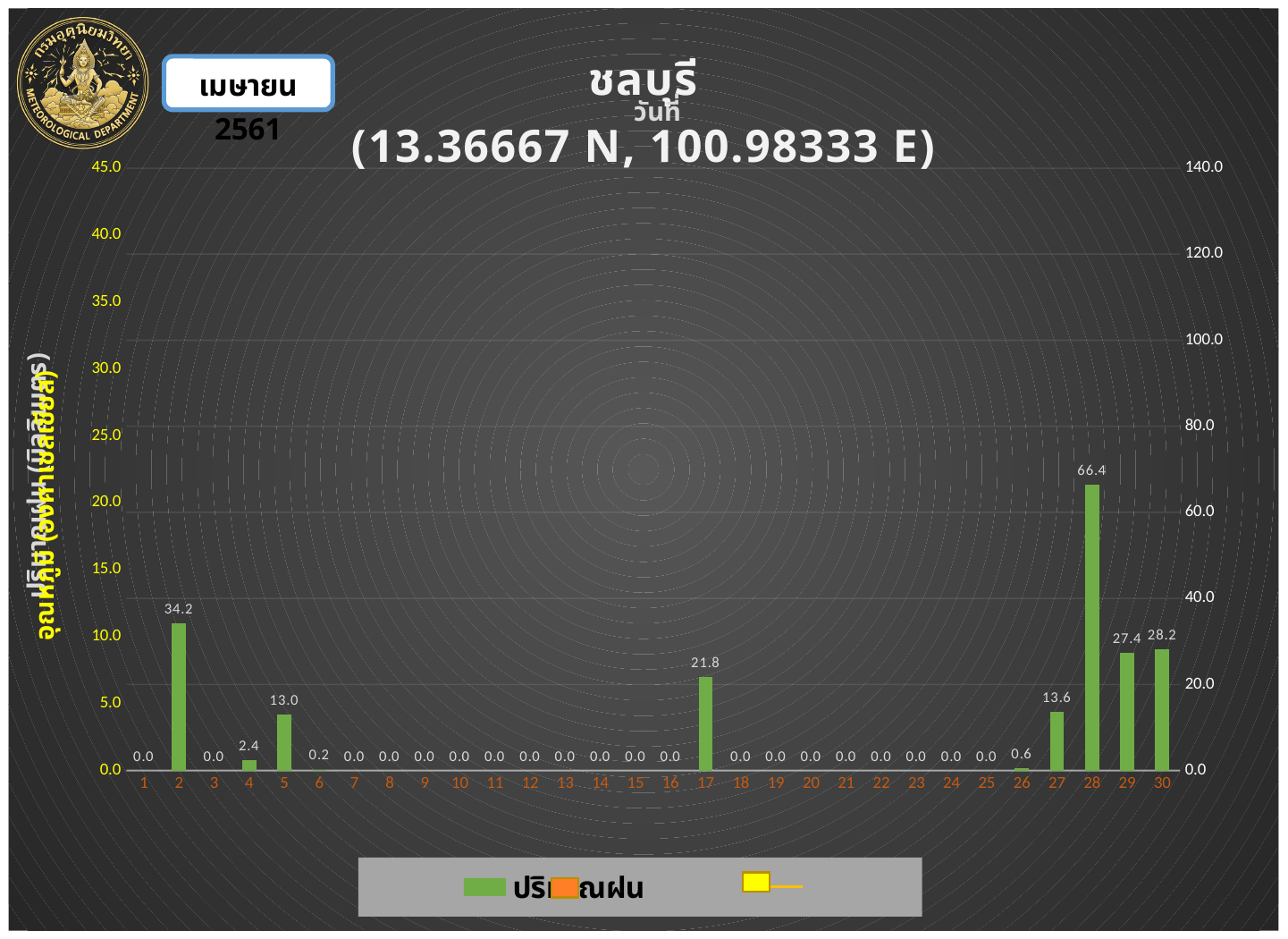
What kind of chart is shown on the slide? bar chart What is the rainfall value for day 6? 0.2 Which day has the highest rainfall value? 28 What is the rainfall value for day 27? 13.6 What is the rainfall value for day 2? 34.2 What is the difference between the rainfall values for day 30 and day 29? 0.8 Is the value for day 28 greater or less than 60.0 on the right axis? greater What is the difference between the rainfall values for day 28 and day 2? 32.2 What is the rainfall value for day 28? 66.4 Which has a larger rainfall value, day 2 or day 17? day 2 What is the rainfall value for day 17? 21.8 How many days are shown on the x axis? 30